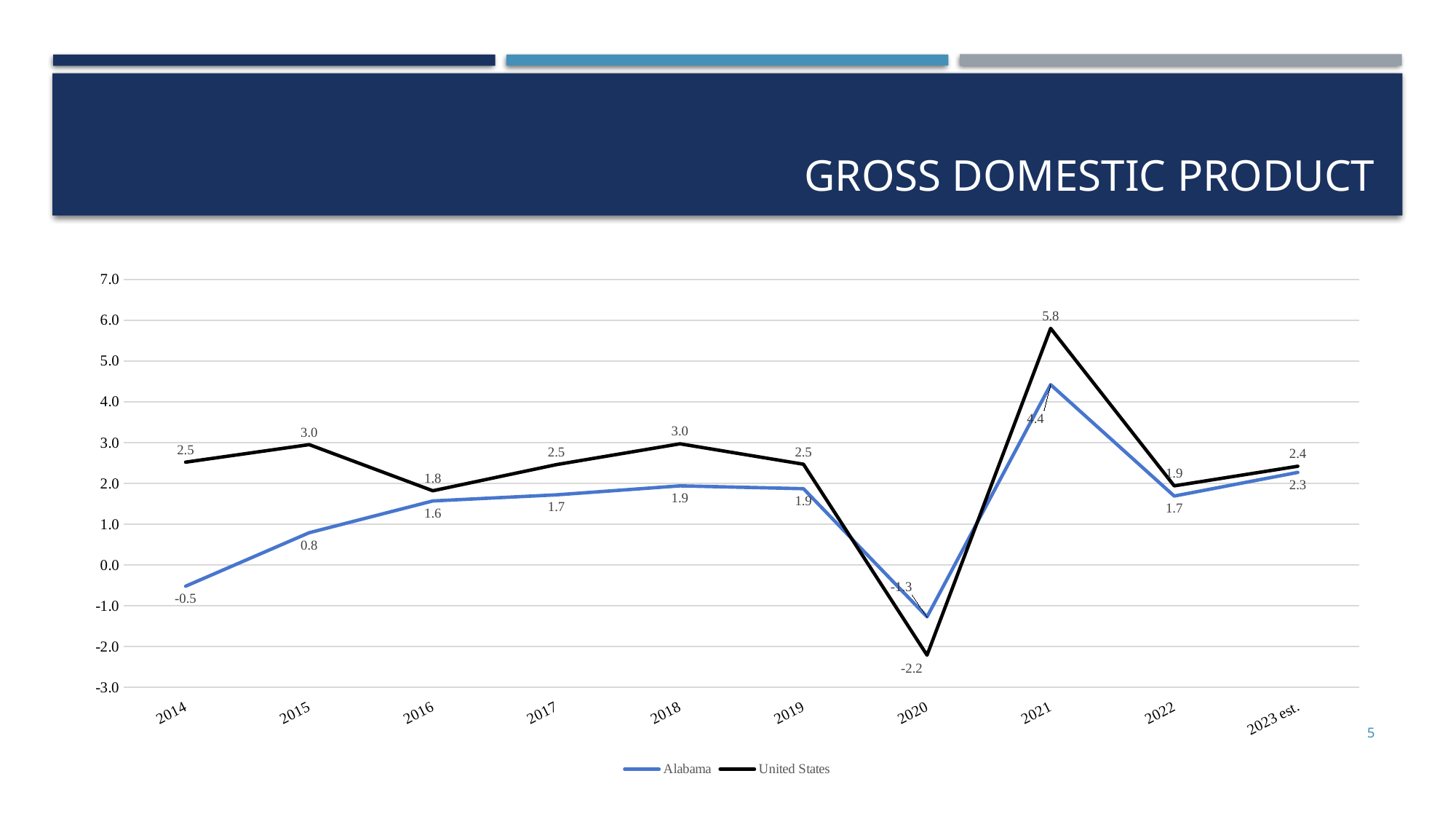
In which year does the United States series reach its highest value? 2021 What is the value for Alabama in 2014? -0.5 What is the value for Alabama in 2020? -1.3 Which series has the larger value in 2015, Alabama or United States? United States What type of chart is shown on the slide? line chart Does the Alabama series rise or fall from 2014 to 2018? rise What is the value for the United States in 2021? 5.8 What is the difference between the United States and Alabama values in 2021? 1.4 How many series does the legend list? 2 In which year does the Alabama series reach its lowest value? 2020 How many years are shown on the x axis? 10 What is the value for the United States in 2023 est.? 2.4